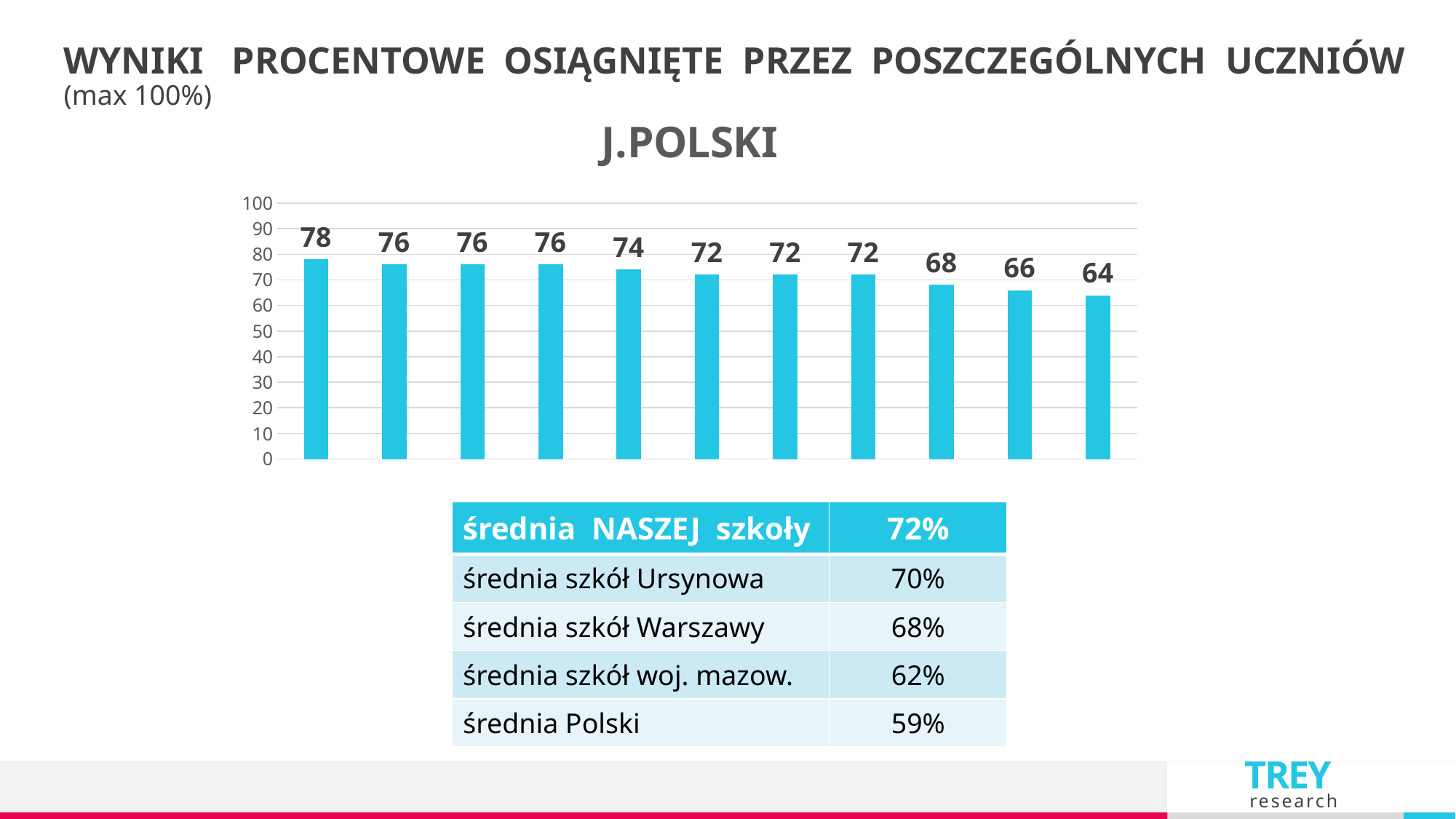
How many bars are plotted in the chart? 11 What is the difference between the highest and lowest values in the chart? 14 Is the value of the rightmost bar greater or less than 70? less How many bars have a value of 72? 3 Do the values rise or fall from left to right along the x axis? fall What is the value of the first (leftmost) bar? 78 What is the value of the fifth bar from the left? 74 What is the lowest value shown in the chart? 64 What is the title of the chart? J.POLSKI What is the highest value shown in the chart? 78 What type of chart is shown on the slide? bar chart What is the value of the last (rightmost) bar? 64